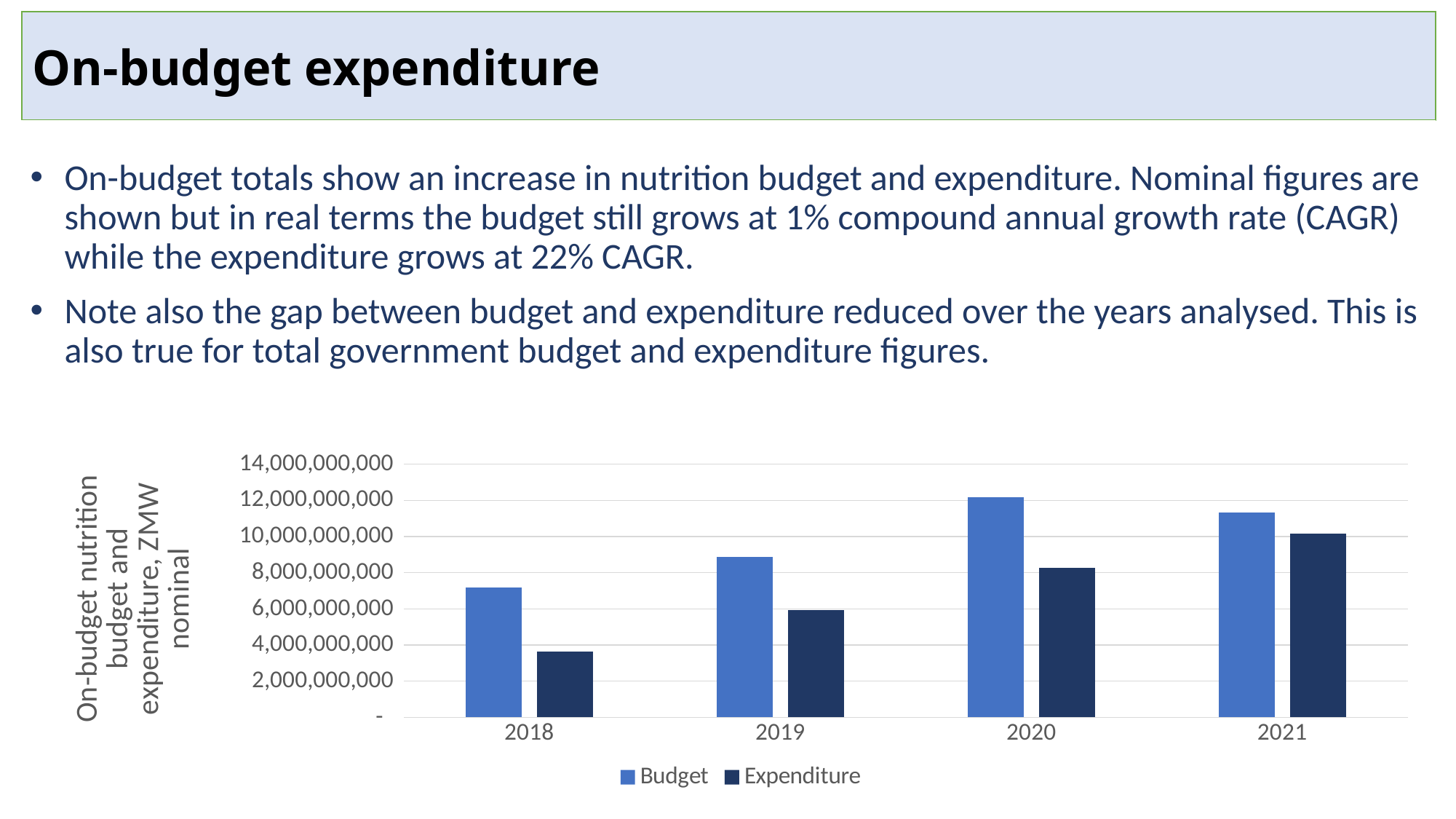
Is the Budget value for 2018 greater or less than 6,000,000,000? greater Which is larger in 2019, the Budget or the Expenditure? Budget Does the Expenditure series rise or fall from 2018 to 2021? Rise Is the Expenditure value for 2020 greater or less than 10,000,000,000? less What kind of chart is shown on the slide? Bar chart How many series does the chart legend list? 2 In which year is the Budget bar highest? 2020 In which year is the Expenditure bar lowest? 2018 How many years are shown on the x axis of the chart? 4 In which year is the Expenditure bar highest? 2021 Is the Budget value for 2021 greater or less than 10,000,000,000? greater